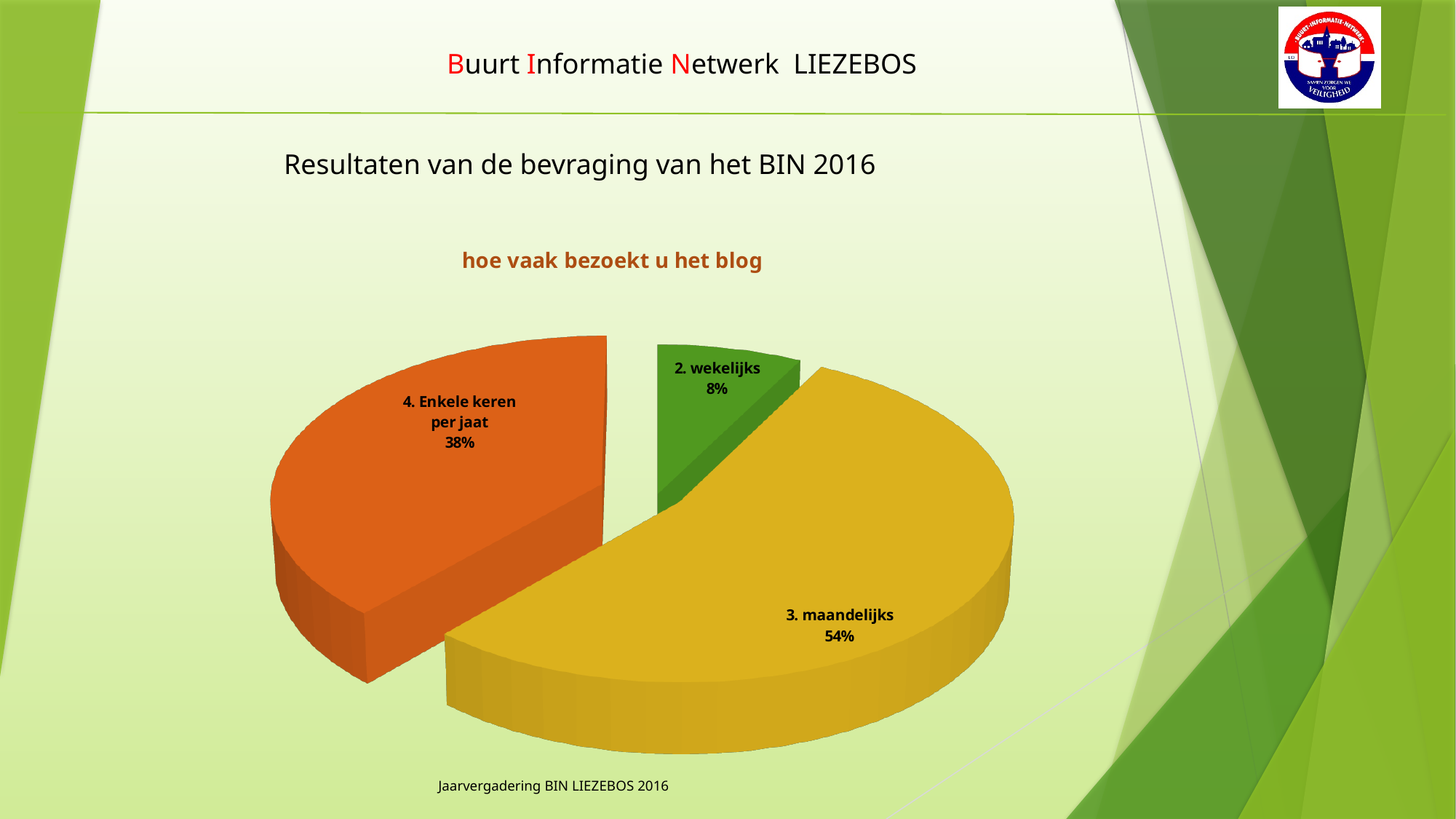
Which slice of the pie is the smallest? 2. wekelijks What is the difference in percentage points between "3. maandelijks" and "4. Enkele keren per jaat"? 16 What is the difference in percentage points between "4. Enkele keren per jaat" and "2. wekelijks"? 30 What share of the pie is labelled "2. wekelijks"? 8% What colour is the slice for "3. maandelijks"? yellow Which is larger: the share for "2. wekelijks" or the share for "4. Enkele keren per jaat"? 4. Enkele keren per jaat What share of the pie is labelled "4. Enkele keren per jaat"? 38% What kind of chart is shown on the slide? pie chart What share of the pie is labelled "3. maandelijks"? 54% Which slice of the pie is the largest? 3. maandelijks What is the title of the chart? hoe vaak bezoekt u het blog How many slices does the pie chart have? 3